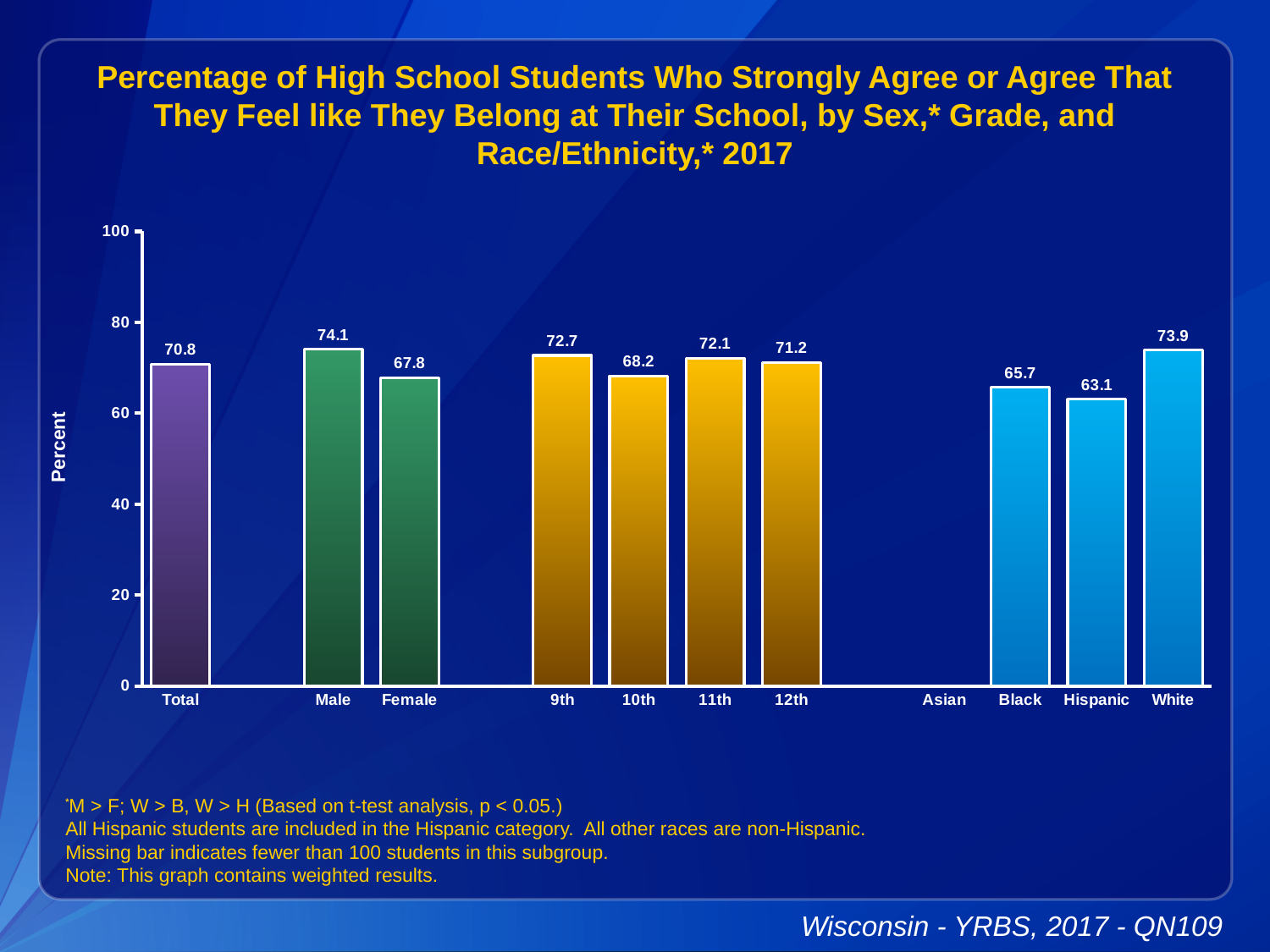
Which category has the highest value? Male Is the value for Black greater or less than 60? greater How many bars are plotted on the chart? 11 What is the value for Total? 70.8 Which is larger, the value for 9th grade or the value for 12th grade? 9th Which category label has no bar plotted? Asian What is the value for 10th grade? 68.2 What is the difference between the Male and Female values? 6.3 What is the value for Hispanic? 63.1 What is the value for Female? 67.8 Which category has the lowest value among the bars shown? Hispanic What kind of chart is shown? bar chart